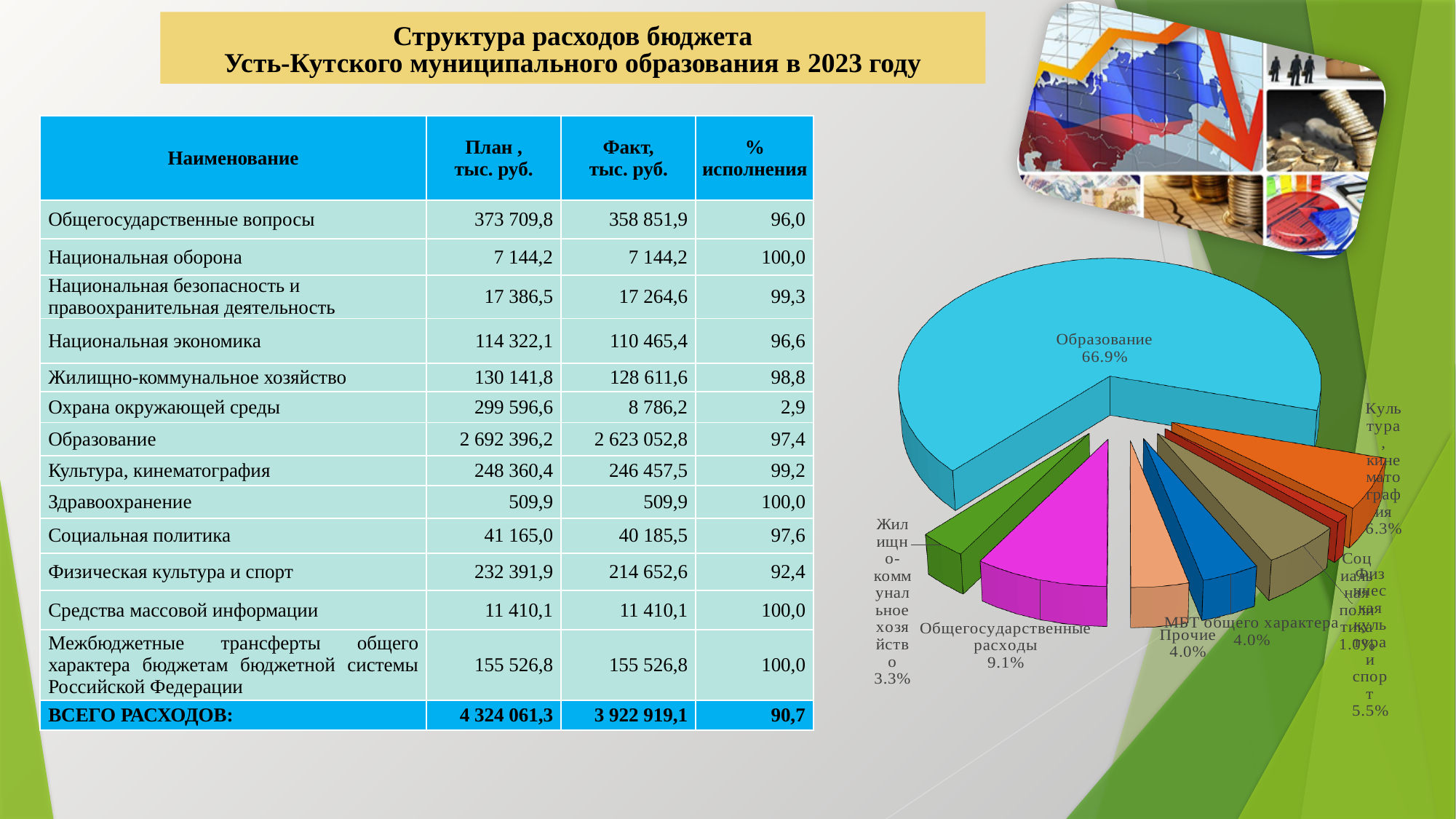
What kind of chart is shown on the right side of the slide? pie chart In the pie chart, what share is shown for Жилищно-коммунальное хозяйство? 3.3% In the pie chart, which is larger: the share of Общегосударственные расходы or the share of Культура, кинематография? Общегосударственные расходы In the pie chart, what share is shown for Культура, кинематография? 6.3% In the pie chart, what share is shown for Прочие? 4.0% In the pie chart, which category has the largest share? Образование In the pie chart, what share is shown for Общегосударственные расходы? 9.1% In the pie chart, how many percentage points larger is the share of Образование than the share of Общегосударственные расходы? 57.8 In the pie chart, what share is shown for МБТ общего характера? 4.0% In the pie chart, what share is shown for Образование? 66.9% In the pie chart, which is larger: the share of Жилищно-коммунальное хозяйство or the share of Прочие? Прочие How many slices does the pie chart have? 8